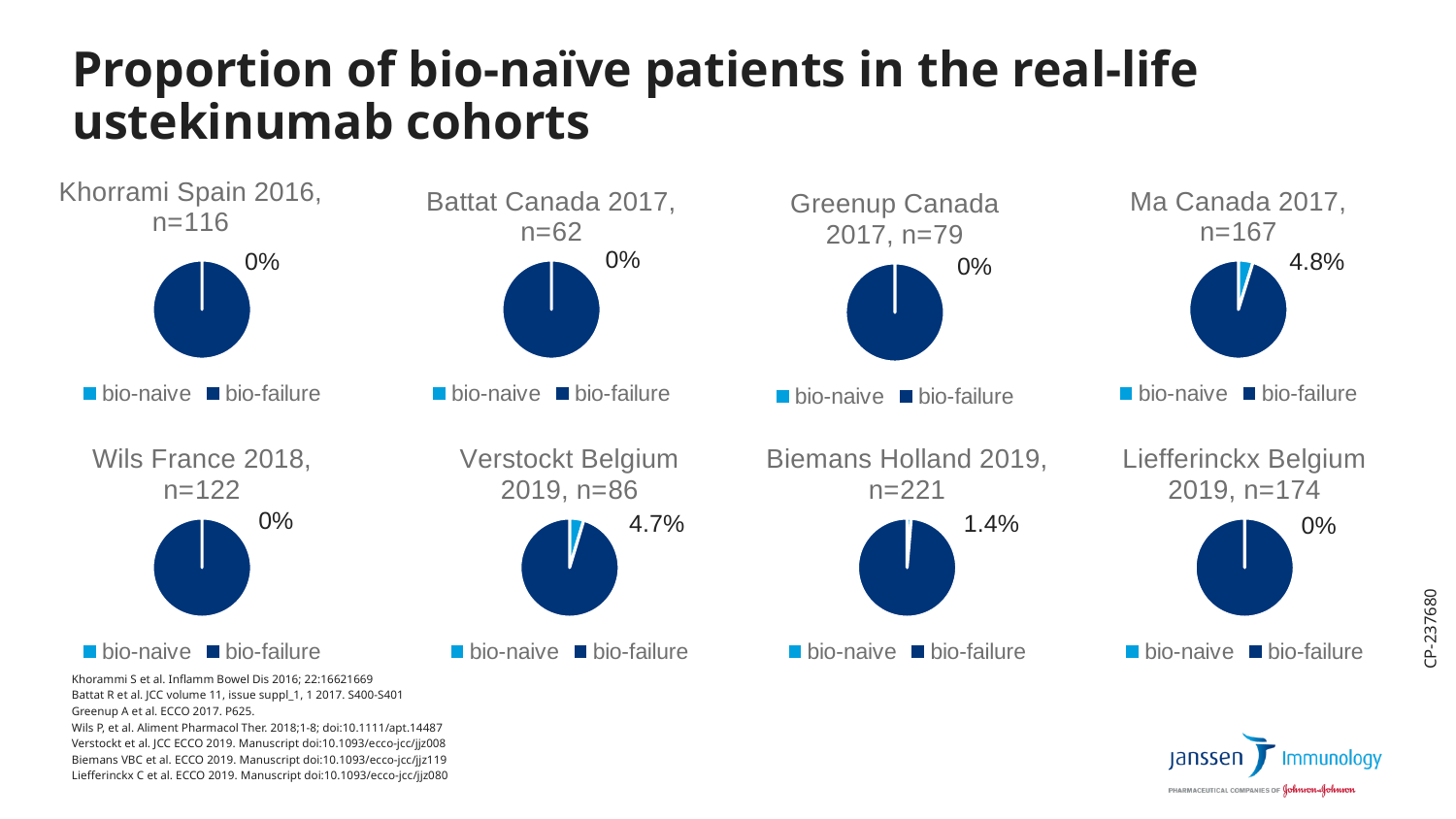
What type of chart is used for each cohort on the slide? Pie chart In the Ma Canada 2017, n=167 chart, what percentage of patients are bio-naive? 4.8% How many charts are shown on the slide? 8 In the Liefferinckx Belgium 2019, n=174 chart, what percentage of patients are bio-naive? 0% Across all the charts on the slide, which cohort has the highest proportion of bio-naive patients? Ma Canada 2017, n=167 What is the difference in bio-naive percentage between the Ma Canada 2017 chart and the Biemans Holland 2019 chart? 3.4 percentage points In the Biemans Holland 2019, n=221 chart, what percentage of patients are bio-naive? 1.4% In the Verstockt Belgium 2019, n=86 chart, what percentage of patients are bio-naive? 4.7% Which has a larger bio-naive proportion: the Ma Canada 2017 chart or the Biemans Holland 2019 chart? Ma Canada 2017 In the Khorrami Spain 2016, n=116 chart, what percentage of patients are bio-naive? 0% How many entries does the legend of the Wils France 2018 chart list? 2 In the Biemans Holland 2019, n=221 chart, what share of the pie is bio-failure? 98.6%